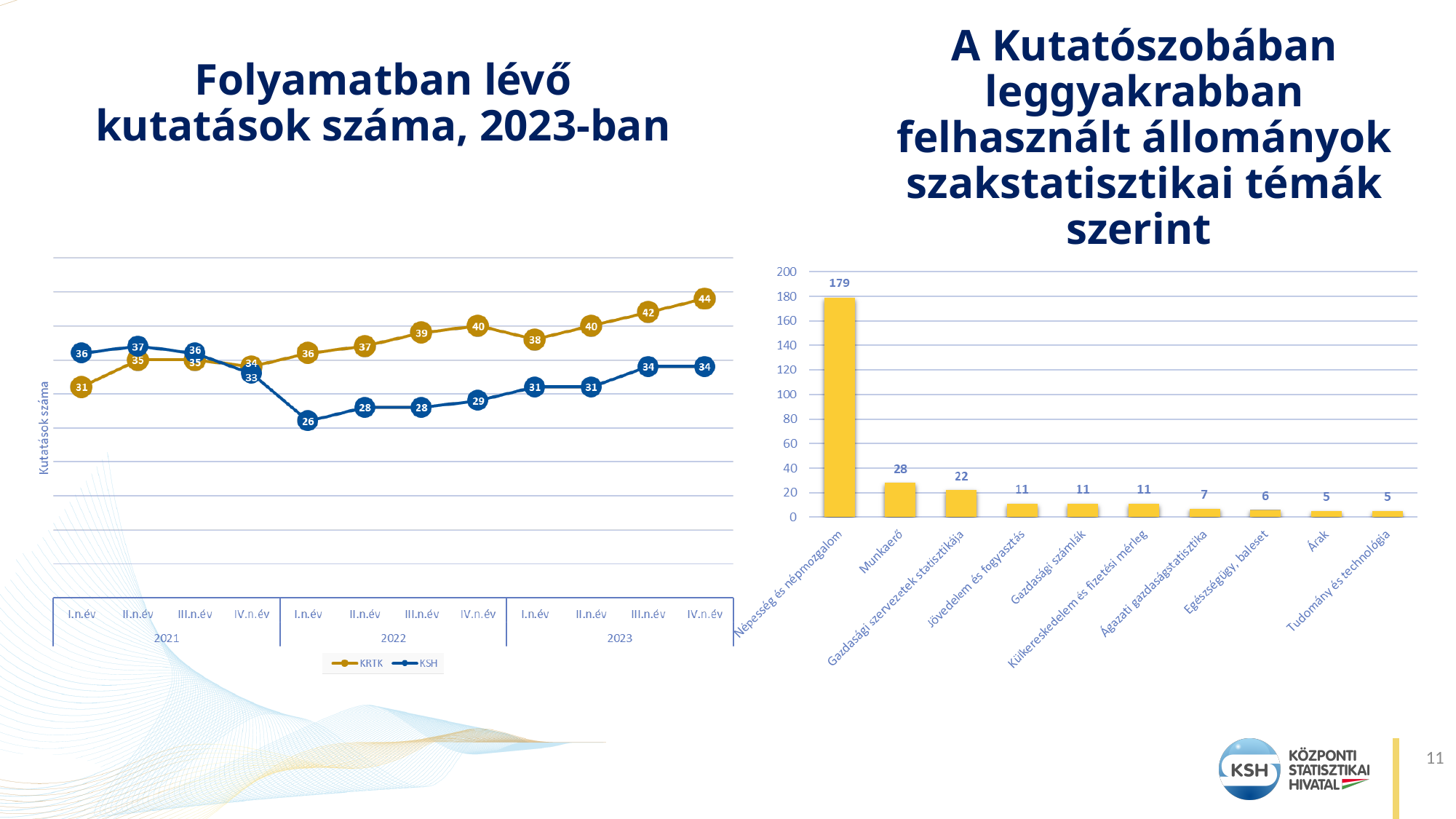
In the line chart 'Folyamatban lévő kutatások száma, 2023-ban', what is the KSH value for I.n.év 2022? 26 In the bar chart on the right, which category has the highest value? Népesség és népmozgalom In the bar chart on the right, what is the value for Munkaerő? 28 In the line chart 'Folyamatban lévő kutatások száma, 2023-ban', does the KRTK series generally rise or fall from I.n.év 2022 to IV.n.év 2023? rise In the line chart 'Folyamatban lévő kutatások száma, 2023-ban', which series has the higher value in I.n.év 2021, KRTK or KSH? KSH In the line chart 'Folyamatban lévő kutatások száma, 2023-ban', how many series does the legend list? 2 In the bar chart on the right, what is the difference between Népesség és népmozgalom and Munkaerő? 151 In the line chart 'Folyamatban lévő kutatások száma, 2023-ban', what is the KRTK value for IV.n.év 2023? 44 In the bar chart on the right, how many categories are shown? 10 What kind of chart is the chart on the right of the slide? bar chart In the line chart 'Folyamatban lévő kutatások száma, 2023-ban', what is the difference between the KRTK and KSH values in IV.n.év 2023? 10 In the bar chart on the right, what is the value for Gazdasági szervezetek statisztikája? 22